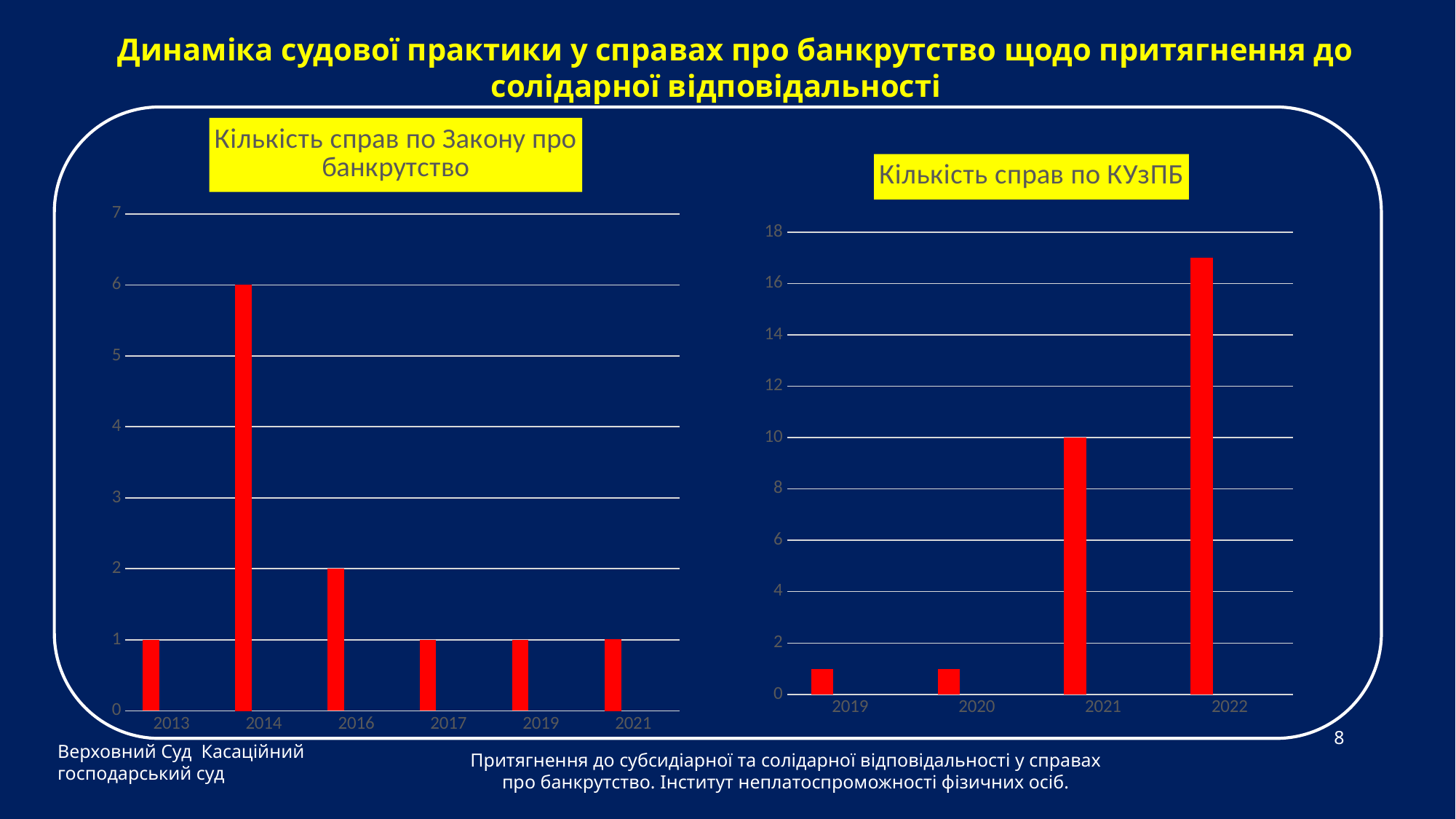
In the right chart 'Кількість справ по КУзПБ', which year has the highest value? 2022 In the right chart 'Кількість справ по КУзПБ', what is the value for 2021? 10 What kind of chart is the left chart, 'Кількість справ по Закону про банкрутство'? bar chart In the right chart 'Кількість справ по КУзПБ', is the value for 2019 greater or less than 2? less In the right chart 'Кількість справ по КУзПБ', how many years are shown on the x axis? 4 In the left chart 'Кількість справ по Закону про банкрутство', which year has the highest value? 2014 In the right chart 'Кількість справ по КУзПБ', which is larger, the value for 2021 or the value for 2022? 2022 In the left chart 'Кількість справ по Закону про банкрутство', what is the value for 2014? 6 In the left chart 'Кількість справ по Закону про банкрутство', how many years are shown on the x axis? 6 In the left chart 'Кількість справ по Закону про банкрутство', what is the value for 2016? 2 In the left chart 'Кількість справ по Закону про банкрутство', what is the difference between the values for 2014 and 2016? 4 In the right chart 'Кількість справ по КУзПБ', is the value for 2022 greater or less than 16? greater